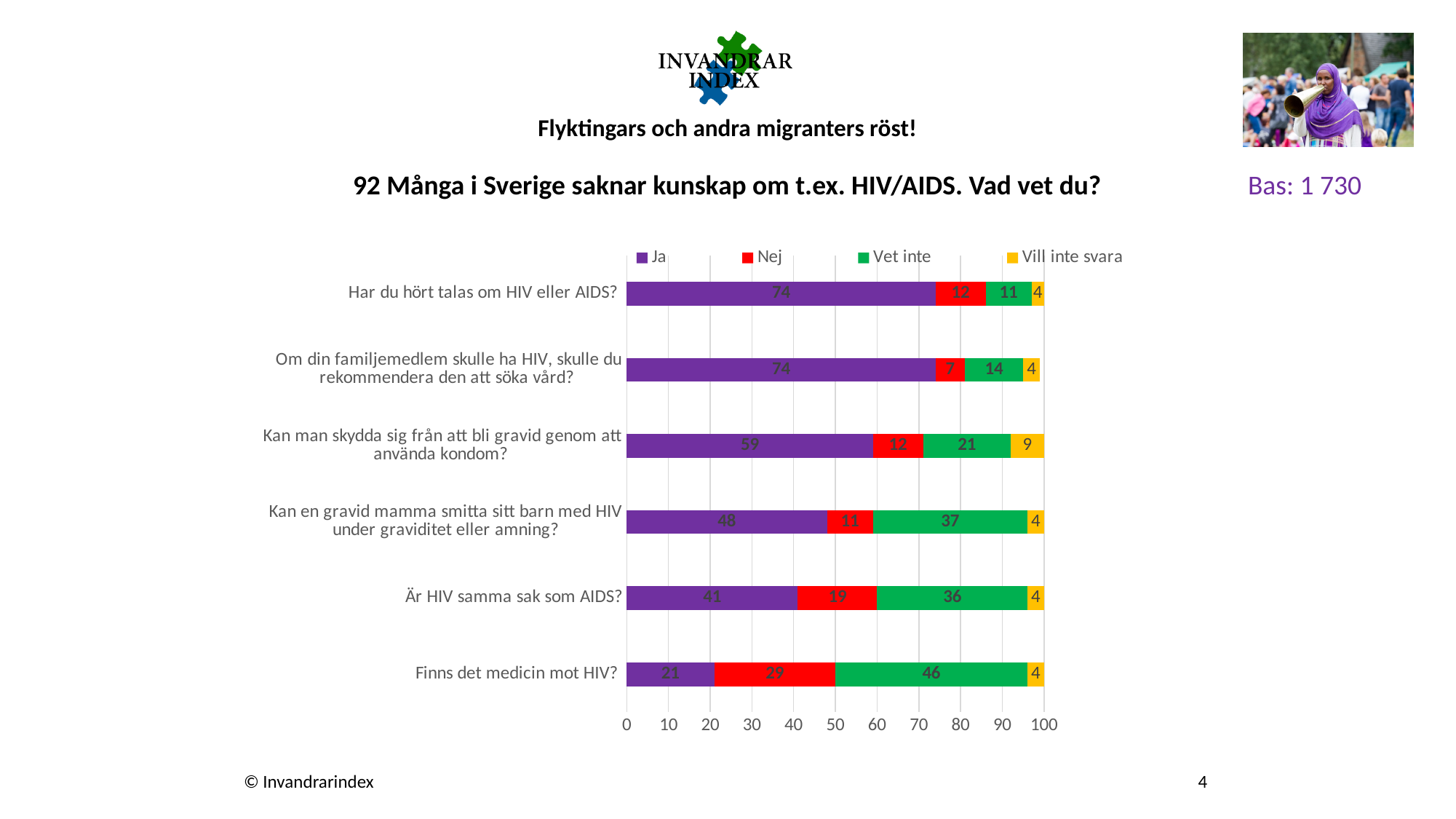
How many series does the legend list? 4 What is the "Vet inte" value for "Kan en gravid mamma smitta sitt barn med HIV under graviditet eller amning?"? 37 What kind of chart is shown on the slide? Stacked bar chart Which category has the lowest "Ja" value? Finns det medicin mot HIV? What is the total of the stacked bar for "Kan man skydda sig från att bli gravid genom att använda kondom?"? 101 What is the "Ja" value for "Finns det medicin mot HIV?"? 21 Which is larger: the "Nej" value for "Finns det medicin mot HIV?" or the "Nej" value for "Är HIV samma sak som AIDS?"? Finns det medicin mot HIV? How many categories (questions) are shown in the chart? 6 What is the "Vill inte svara" value for "Kan man skydda sig från att bli gravid genom att använda kondom?"? 9 Which category has the highest "Vet inte" value? Finns det medicin mot HIV? What is the difference between the "Ja" values for "Har du hört talas om HIV eller AIDS?" and "Är HIV samma sak som AIDS?"? 33 What is the "Nej" value for "Är HIV samma sak som AIDS?"? 19